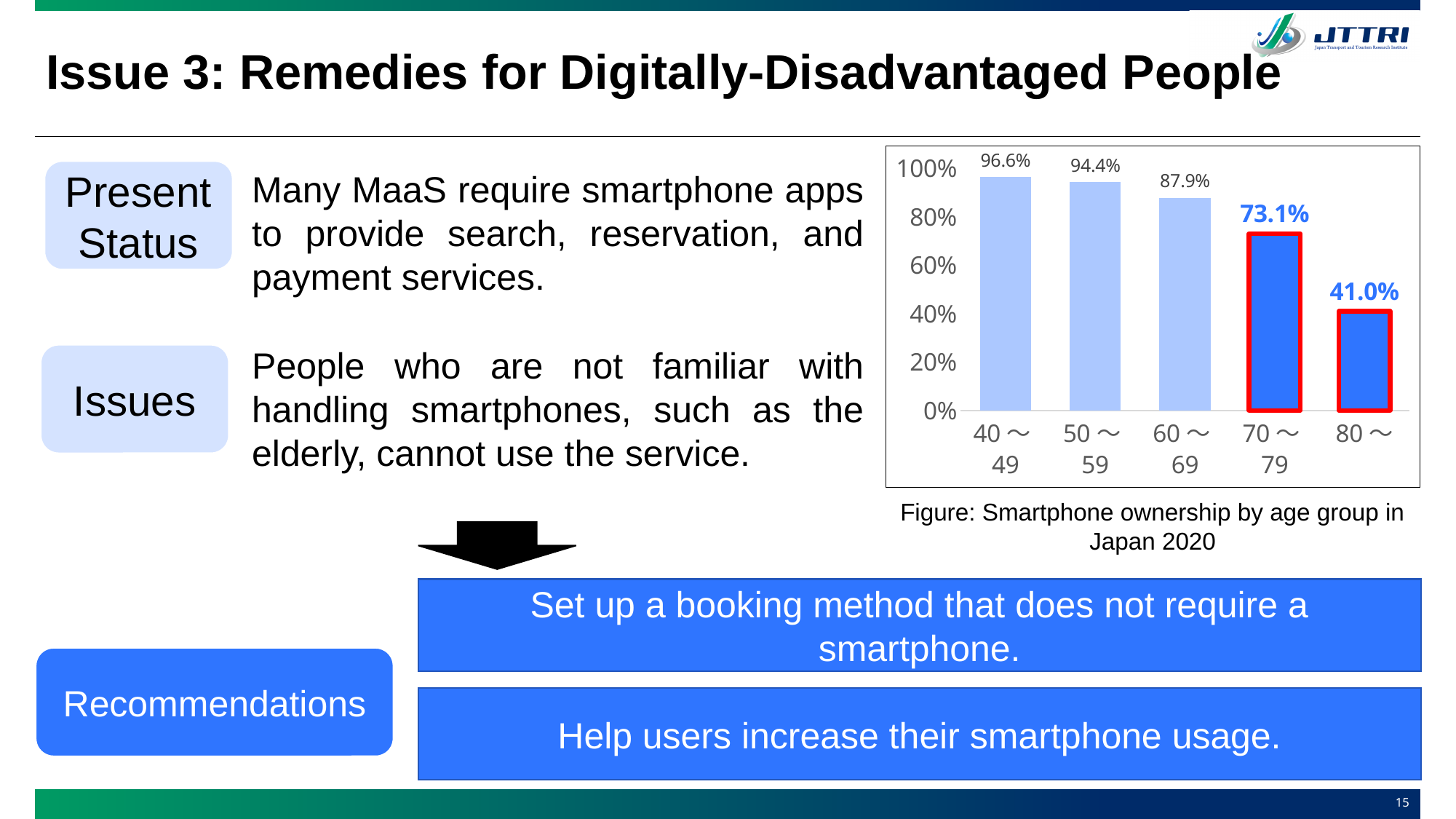
What is the difference in smartphone ownership between the 70–79 and 80 and over age groups? 32.1 percentage points What is the smartphone ownership rate for the 70–79 age group? 73.1% How many age groups are shown in the chart? 5 Which age groups are highlighted with red outlines in the chart? 70–79 and 80 and over Do smartphone ownership rates rise or fall as age group increases? Fall What is the smartphone ownership rate for the 40–49 age group? 96.6% What type of chart is used to show smartphone ownership by age group? Bar chart What is the smartphone ownership rate for the 80 and over age group? 41.0% Is the smartphone ownership rate for the 60–69 age group greater or less than 80%? greater Which age group has the highest smartphone ownership rate? 40–49 Which age group has a higher smartphone ownership rate, 50–59 or 60–69? 50–59 Which age group has the lowest smartphone ownership rate? 80 and over